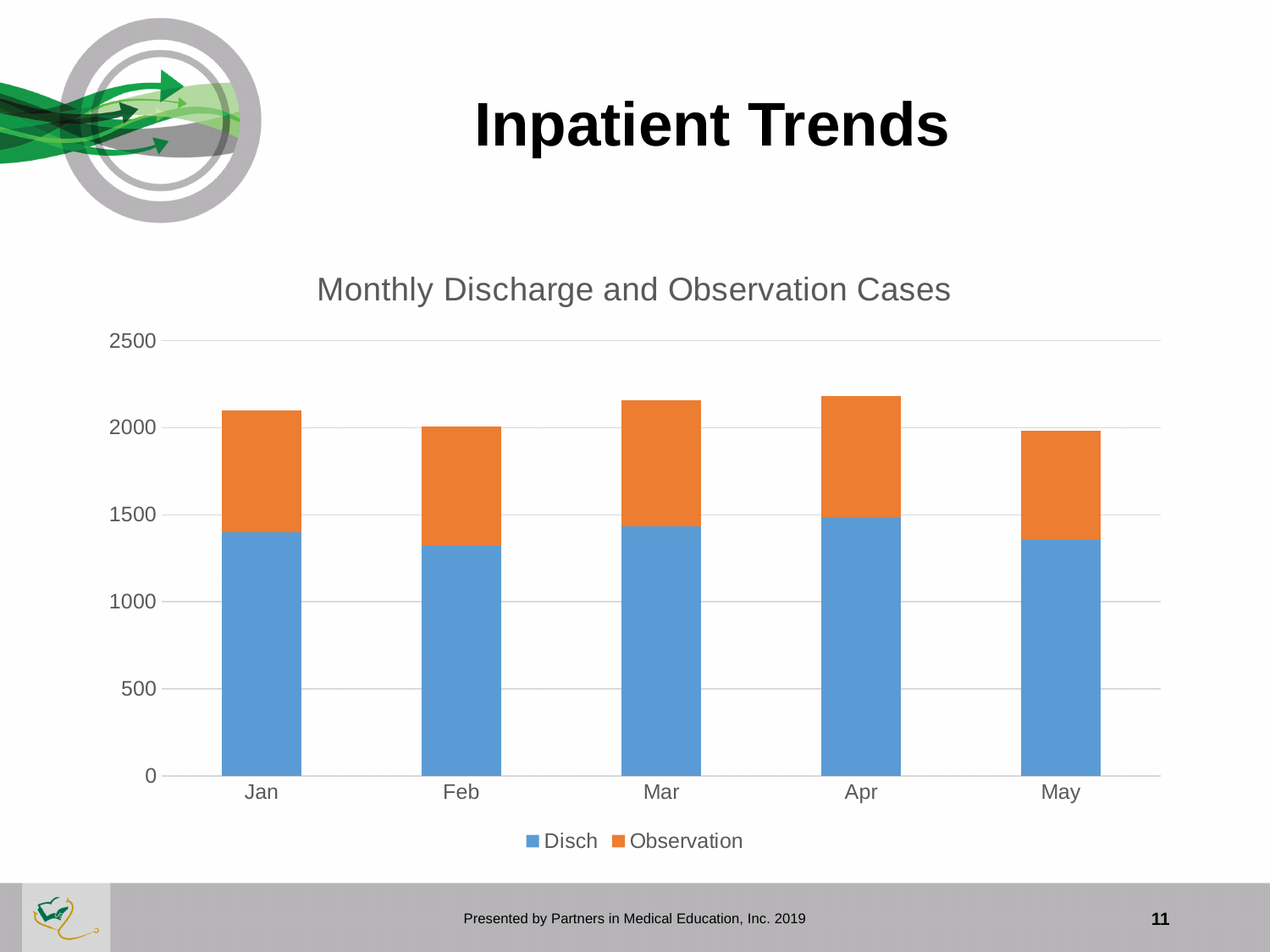
What is the title of the chart? Monthly Discharge and Observation Cases Is the total stacked bar for Apr greater or less than 2500? less Is the total stacked bar for Mar greater or less than 2000? greater Is the Disch value for Feb greater or less than 1000? greater Which series is shown in orange in the chart? Observation Which month has the larger Disch value, Apr or May? Apr What kind of chart is shown on the slide? Stacked bar chart How many series does the chart legend list? 2 Which month has the larger total stacked bar, Jan or Feb? Jan How many months are shown on the x axis of the chart? 5